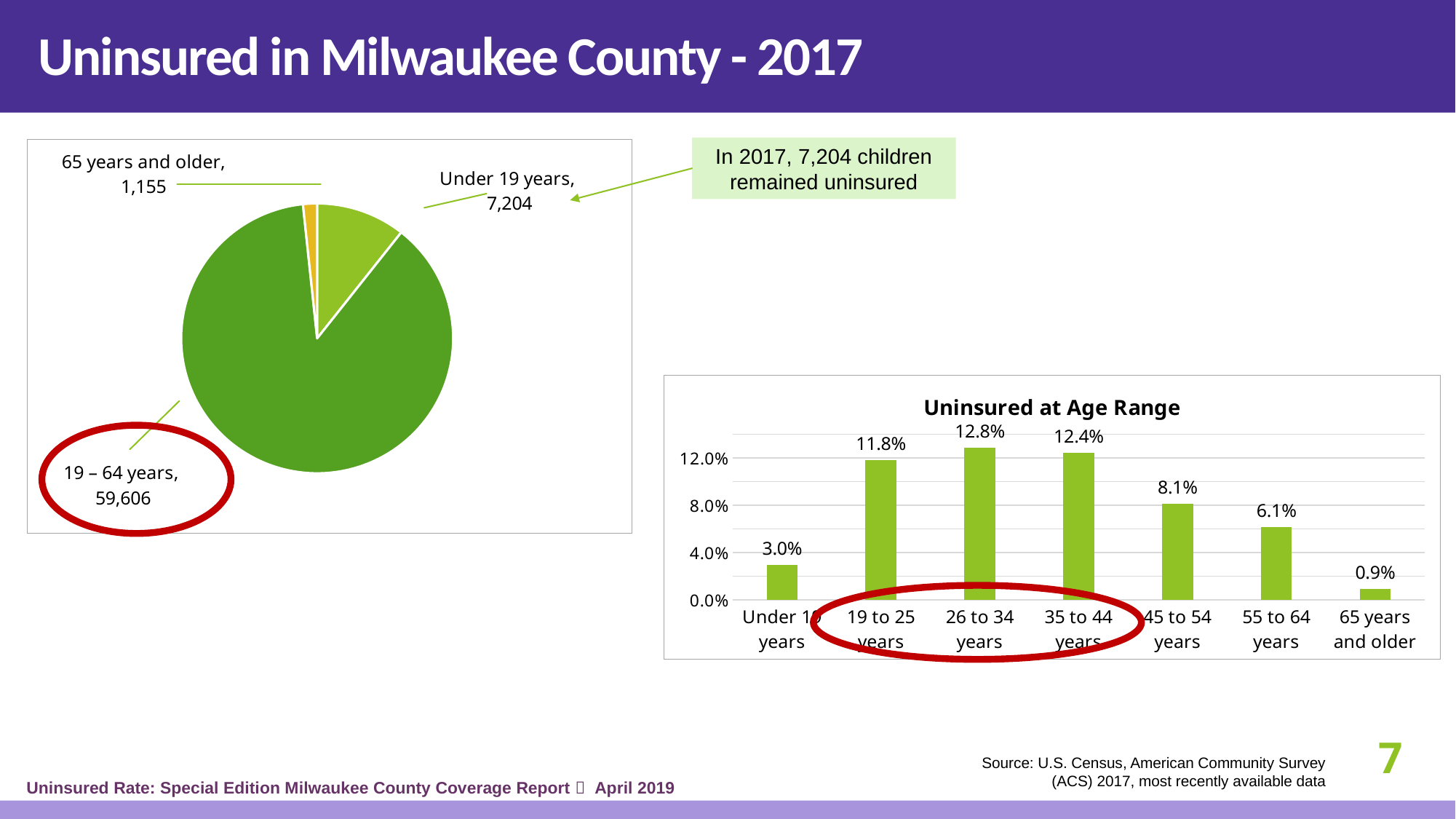
In the 'Uninsured at Age Range' chart, which age range has the highest uninsured rate? 26 to 34 years In the pie chart on the left, what is the difference between the Under 19 years value and the 65 years and older value? 6,049 In the 'Uninsured at Age Range' chart, how many age ranges are shown? 7 What kind of chart is 'Uninsured at Age Range'? Bar chart In the pie chart on the left, how many slices are there? 3 In the 'Uninsured at Age Range' chart, what is the value for 45 to 54 years? 8.1% In the pie chart on the left, how many people aged 19 – 64 years are uninsured? 59,606 In the 'Uninsured at Age Range' chart, what is the difference between the 26 to 34 years value and the 19 to 25 years value? 1.0% In the 'Uninsured at Age Range' chart, which age range has the lowest uninsured rate? 65 years and older In the pie chart on the left, which category has the smallest slice? 65 years and older In the 'Uninsured at Age Range' chart, which is larger: the value for 35 to 44 years or the value for 55 to 64 years? 35 to 44 years In the pie chart on the left, what is the value for Under 19 years? 7,204